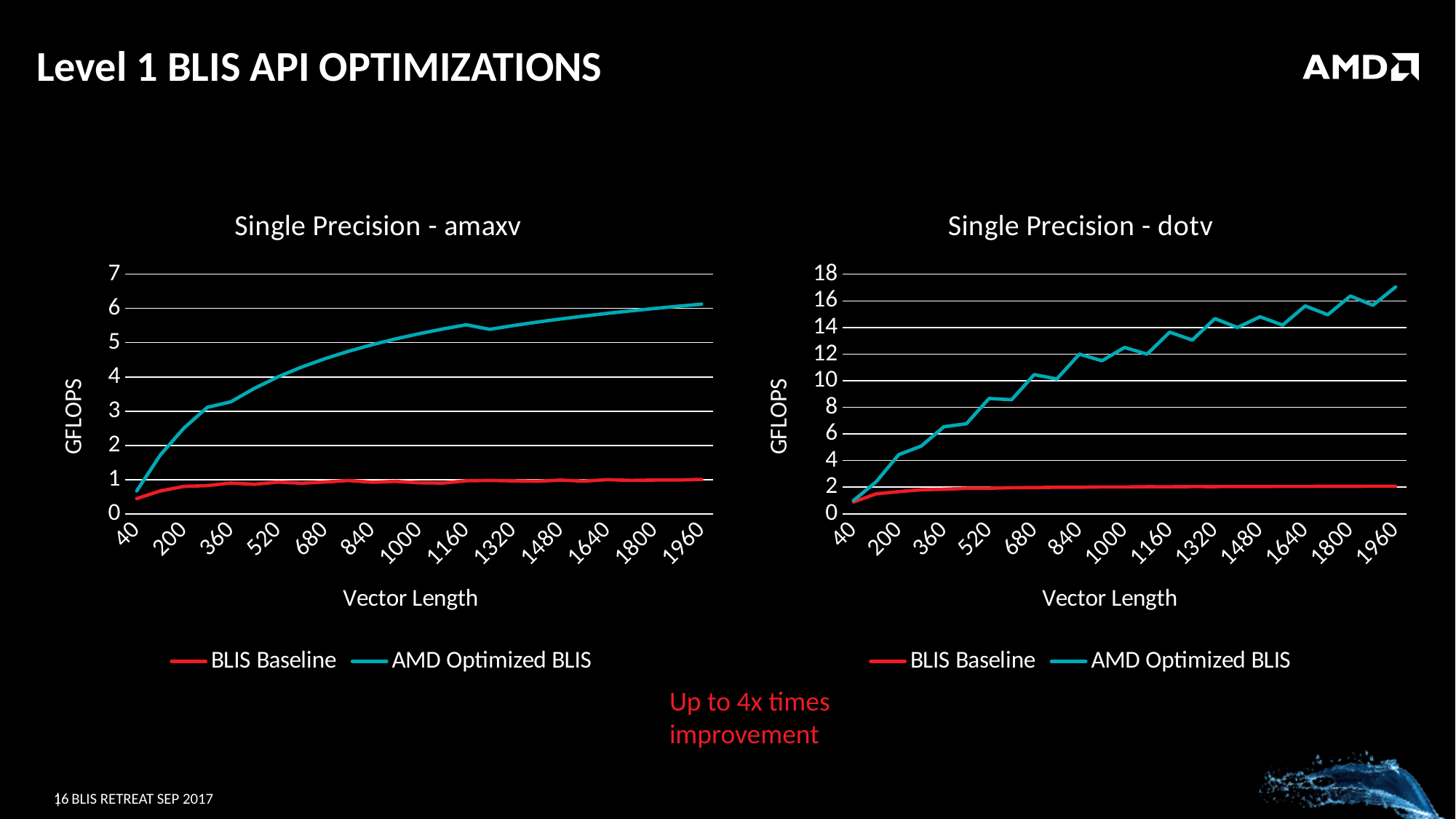
In the 'Single Precision - amaxv' chart, is the AMD Optimized BLIS value at vector length 1960 greater or less than 5? greater In the 'Single Precision - dotv' chart, is the BLIS Baseline value at vector length 1960 greater or less than 4? less What is the y-axis label of the 'Single Precision - amaxv' chart? GFLOPS What kind of chart is the 'Single Precision - amaxv' chart? line chart In the 'Single Precision - dotv' chart, is the AMD Optimized BLIS value at vector length 1960 greater or less than 14? greater In the 'Single Precision - amaxv' chart, does the AMD Optimized BLIS line rise or fall as vector length increases? rise In the 'Single Precision - dotv' chart, which series has the higher value at vector length 1960, BLIS Baseline or AMD Optimized BLIS? AMD Optimized BLIS In the 'Single Precision - amaxv' chart, which series has the lower value at vector length 1000, BLIS Baseline or AMD Optimized BLIS? BLIS Baseline How many series does the legend of the 'Single Precision - dotv' chart list? 2 In the 'Single Precision - dotv' chart, does the AMD Optimized BLIS line generally rise or fall along the x axis? rise What is the x-axis label of the 'Single Precision - dotv' chart? Vector Length